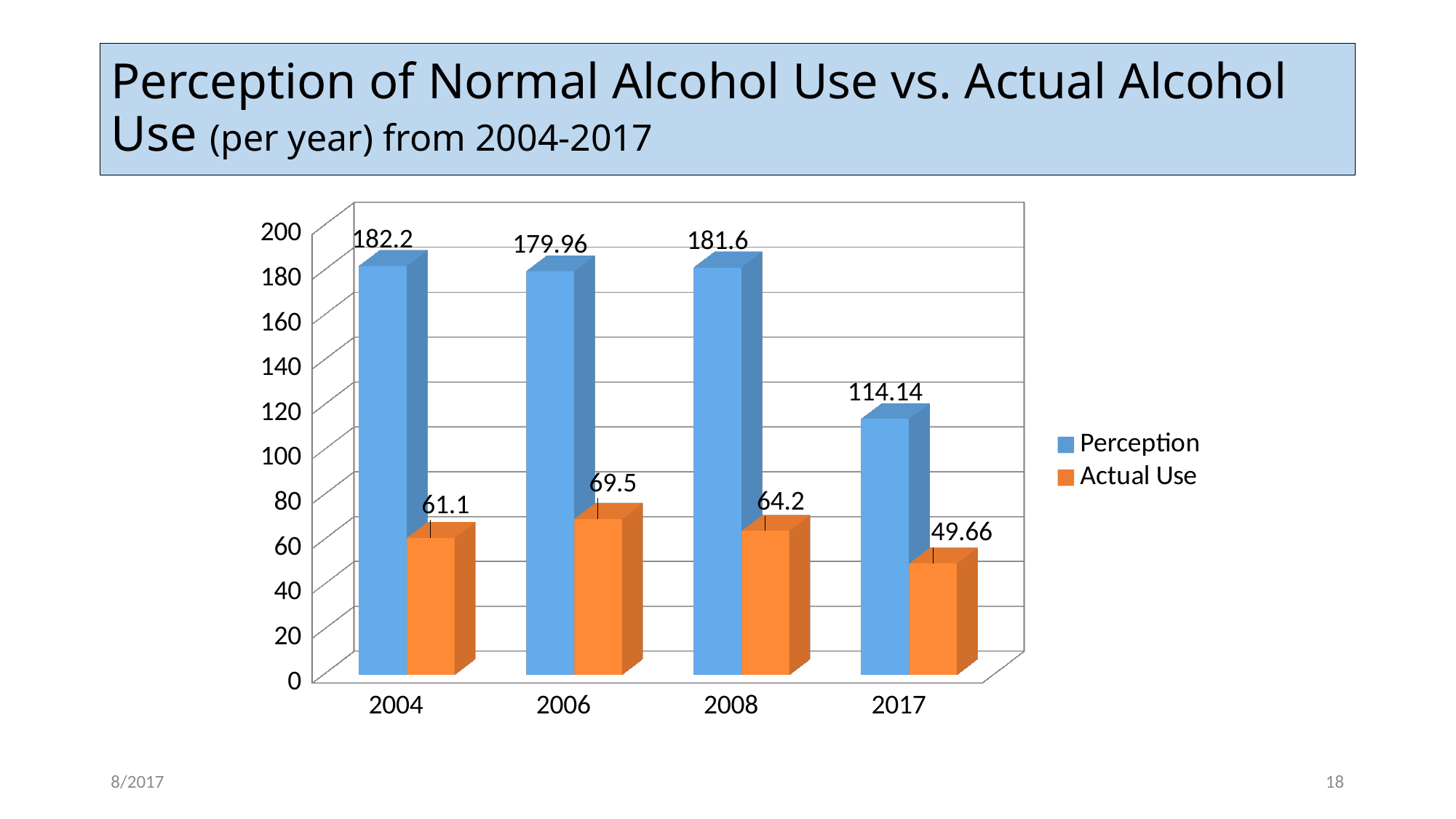
Which colour represents the Actual Use series? orange Which year has the highest Actual Use value? 2006 How many years are shown on the x axis? 4 Which year has the lowest Perception value? 2017 Which is larger, the Actual Use value for 2004 or for 2008? 2008 What is the Perception value for 2004? 182.2 What is the Actual Use value for 2006? 69.5 Is the Perception value for 2017 greater or less than 100? greater What kind of chart is shown on the slide? bar chart What is the Actual Use value for 2017? 49.66 What is the difference between the Perception and Actual Use values for 2008? 117.4 How many series does the legend list? 2